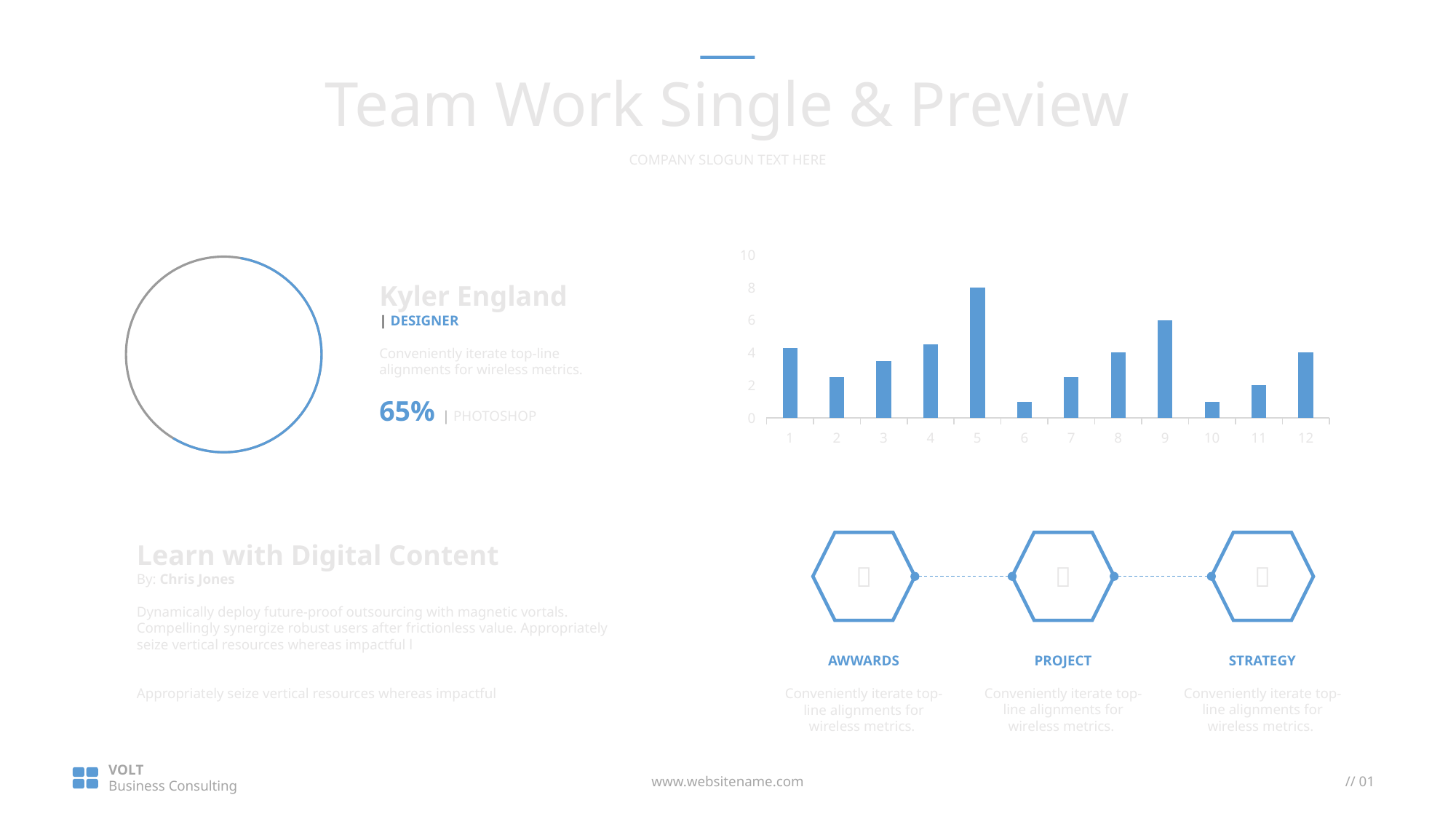
Is the value for category 1 greater or less than 2? greater What kind of chart is shown on the right side of the slide? bar chart Which has the larger value, category 2 or category 4? 4 How many categories are shown on the x axis of the bar chart? 12 Is the value for category 6 greater or less than 2? less Which category has the highest bar in the bar chart? 5 What is the highest tick value shown on the y axis of the bar chart? 10 Is the value for category 4 greater or less than 6? less Which has the larger value, category 5 or category 9? 5 What is the value of the bar for category 9? 6 What is the value of the bar for category 5? 8